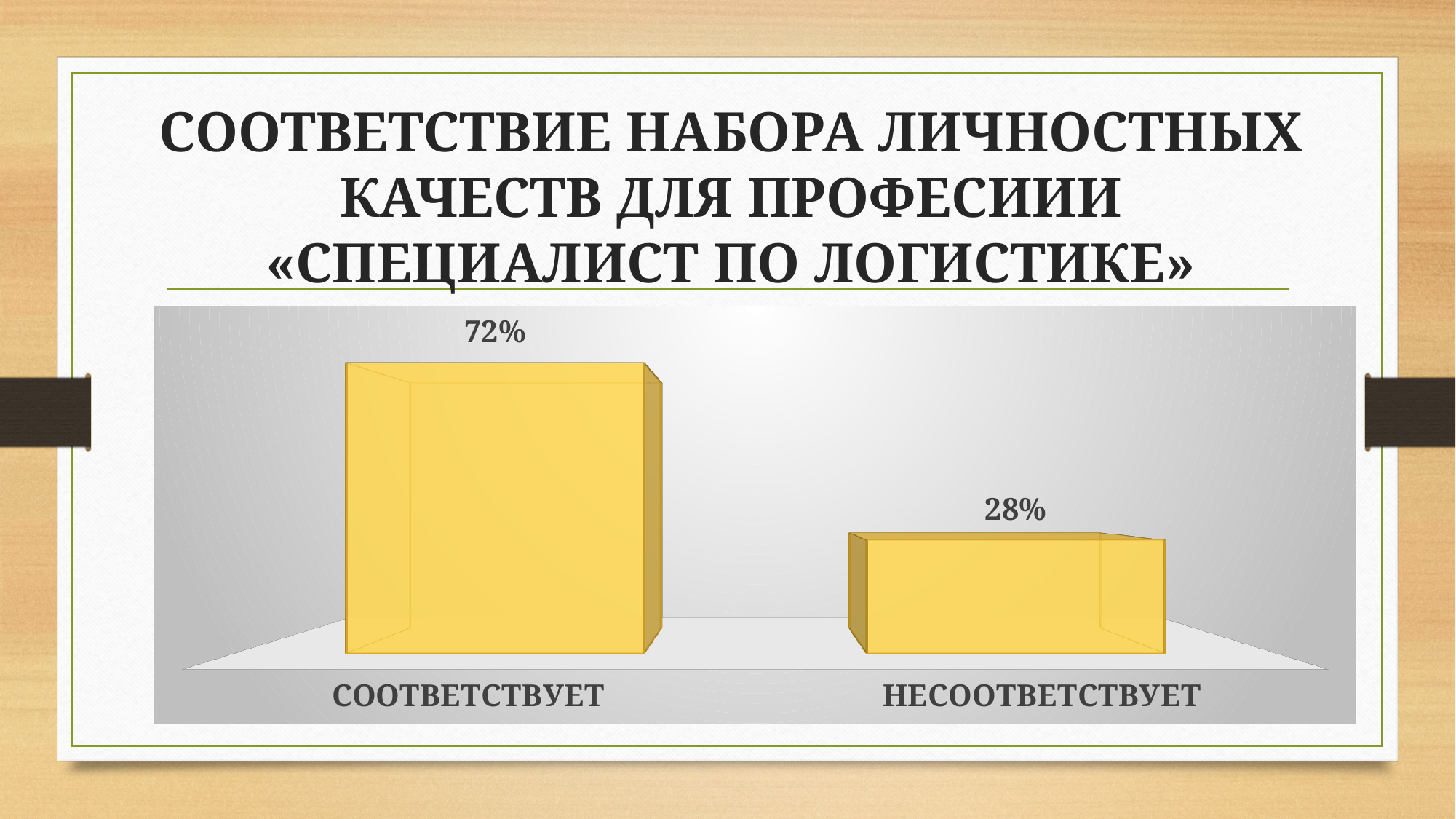
Which category has the lowest value? НЕСООТВЕТСТВУЕТ What kind of chart is shown on the slide? bar chart What colour are the bars in the chart? yellow Which category has the highest value? СООТВЕТСТВУЕТ What is the title of the slide? СООТВЕТСТВИЕ НАБОРА ЛИЧНОСТНЫХ КАЧЕСТВ ДЛЯ ПРОФЕСИИИ «СПЕЦИАЛИСТ ПО ЛОГИСТИКЕ» What is the value for НЕСООТВЕТСТВУЕТ? 28% What is the difference between the values for СООТВЕТСТВУЕТ and НЕСООТВЕТСТВУЕТ? 44% What is the total of the two values shown in the chart? 100% How many categories are shown in the chart? 2 What is the value for СООТВЕТСТВУЕТ? 72% Which is larger, the value for СООТВЕТСТВУЕТ or the value for НЕСООТВЕТСТВУЕТ? СООТВЕТСТВУЕТ